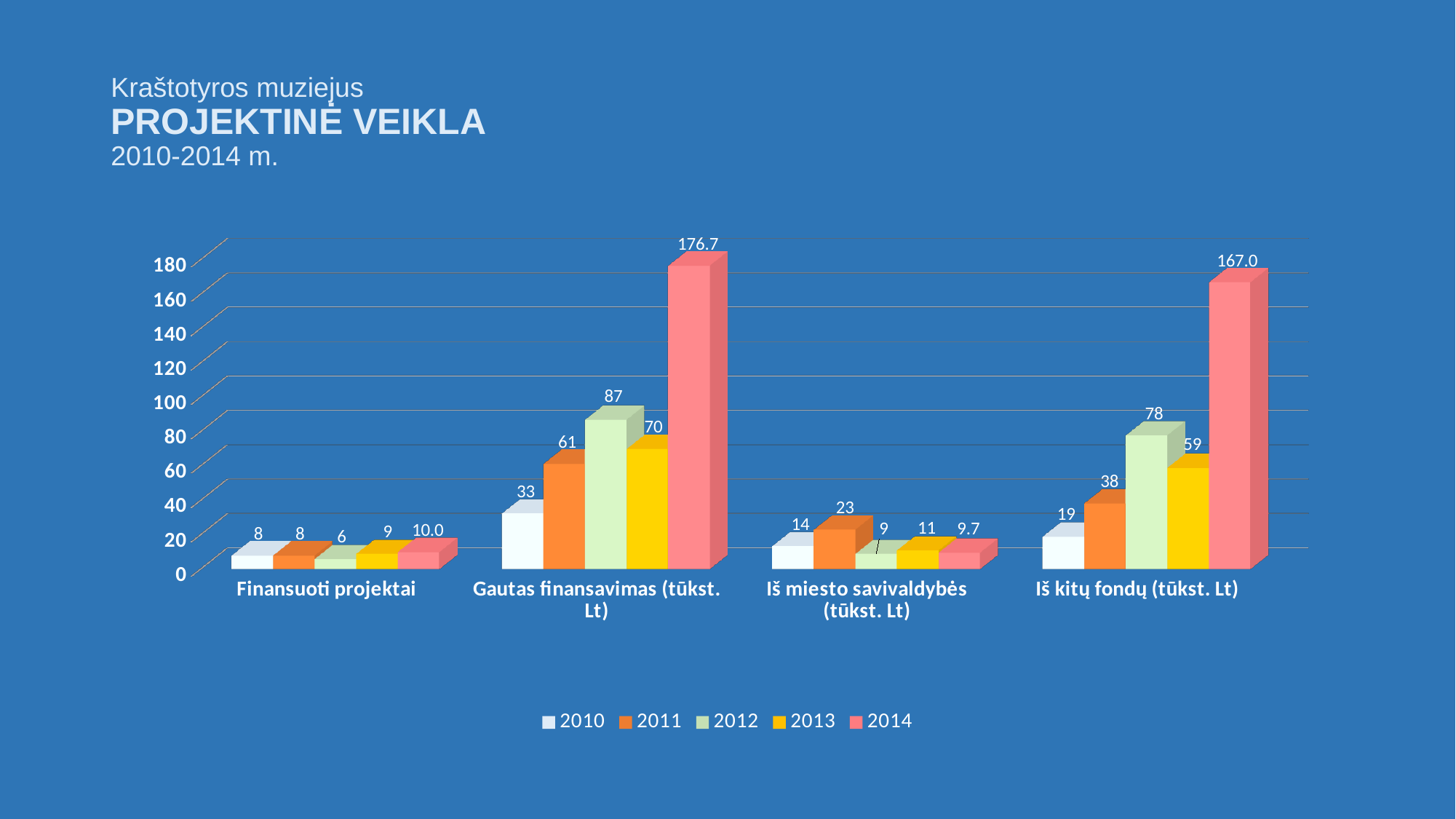
Which year has the highest value in the "Gautas finansavimas (tūkst. Lt)" category? 2014 What is the value for 2011 in the "Iš miesto savivaldybės (tūkst. Lt)" category? 23 How many categories are shown on the x axis? 4 What is the value for 2014 in the "Gautas finansavimas (tūkst. Lt)" category? 176.7 Which year has the lowest value in the "Iš miesto savivaldybės (tūkst. Lt)" category? 2012 What is the value for 2013 in the "Finansuoti projektai" category? 9 What is the value for 2012 in the "Iš kitų fondų (tūkst. Lt)" category? 78 Which year is shown in orange in the legend? 2011 What kind of chart is shown on the slide? Bar chart How many series does the legend list? 5 What is the difference between the 2014 and 2013 values in the "Iš kitų fondų (tūkst. Lt)" category? 108.0 Which is larger in the "Gautas finansavimas (tūkst. Lt)" category: the 2012 value or the 2013 value? 2012